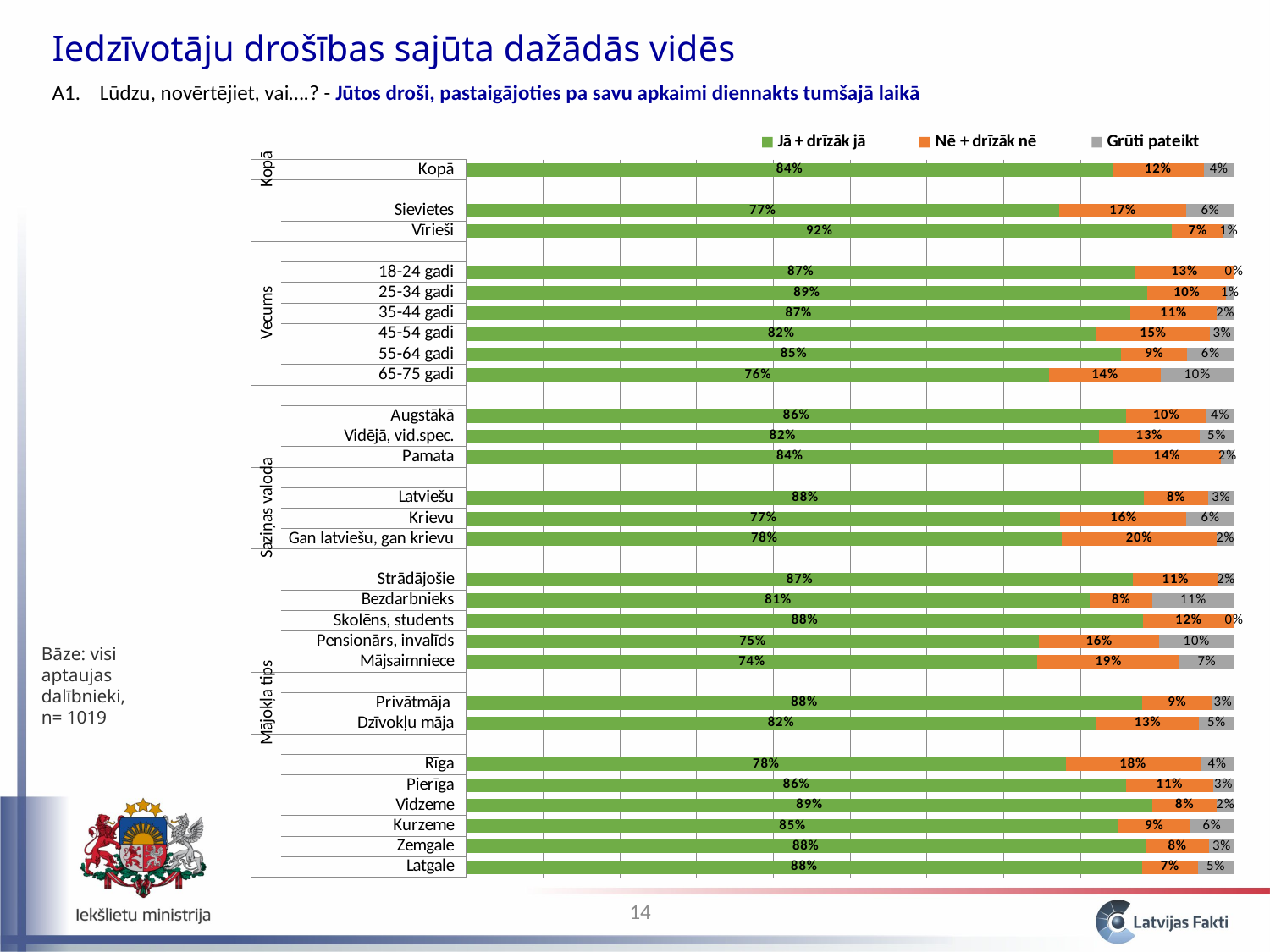
What is the total of the three segments for the Kopā bar? 100% Which colour represents the "Grūti pateikt" series? Grey How many series does the legend list? 3 What is the "Grūti pateikt" value for Bezdarbnieks? 11% What is the difference between the "Jā + drīzāk jā" values for Vīrieši and Sievietes? 15 percentage points What percentage of Vīrieši answered "Jā + drīzāk jā"? 92% What type of chart is shown on the slide? Stacked bar chart Which has a larger "Nē + drīzāk nē" value, Krievu or Latviešu? Krievu Which category has the lowest "Jā + drīzāk jā" share? Mājsaimniece What is the "Nē + drīzāk nē" value for Rīga? 18% Which category has the highest "Nē + drīzāk nē" share? Gan latviešu, gan krievu Which category has the highest "Jā + drīzāk jā" share? Vīrieši